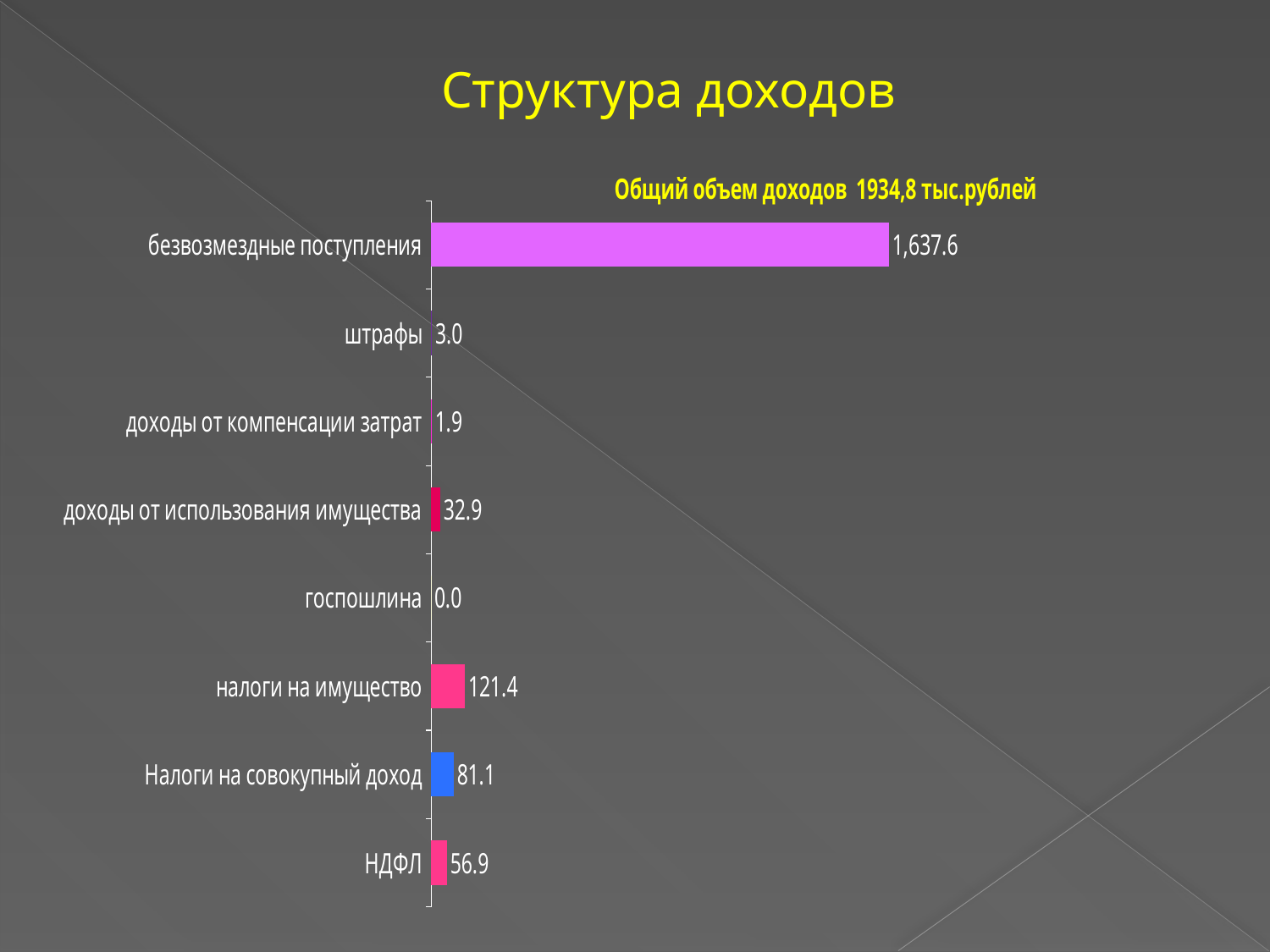
What is the value for доходы от использования имущества? 32.9 Which category has the lowest value? госпошлина What total income amount is stated above the chart? 1934,8 тыс.рублей Which is larger, НДФЛ or Налоги на совокупный доход? Налоги на совокупный доход Which category has the highest value? безвозмездные поступления What kind of chart is shown on the slide? bar chart What is the difference between налоги на имущество and Налоги на совокупный доход? 40.3 How many categories are shown in the chart? 8 What is the value for НДФЛ? 56.9 What is the value for налоги на имущество? 121.4 What is the value for Налоги на совокупный доход? 81.1 What is the value for безвозмездные поступления? 1,637.6